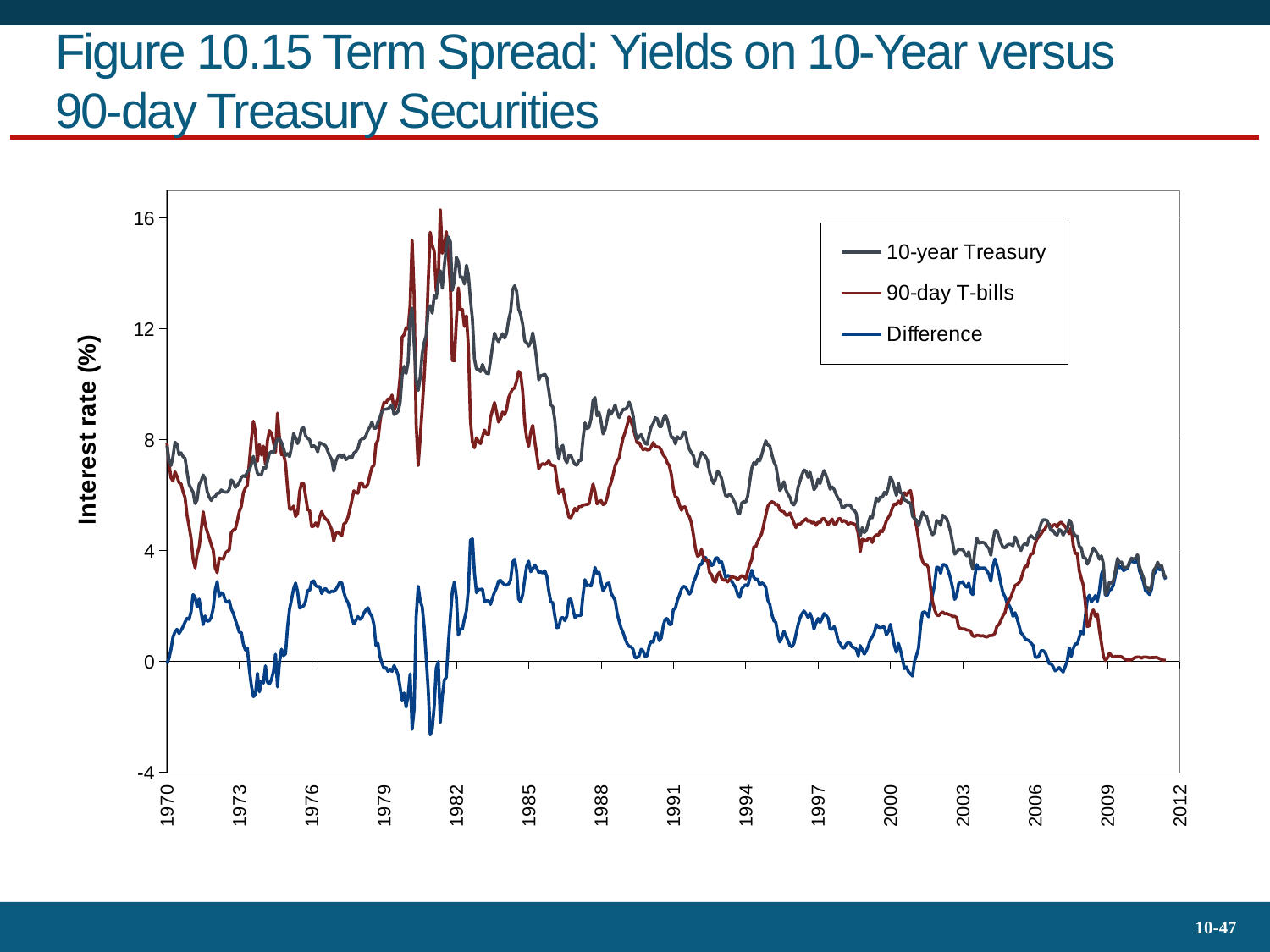
How many series does the legend list? 3 What is the label on the vertical axis? Interest rate (%) What kind of chart is shown on the slide? line chart How many year labels are shown on the horizontal axis? 15 Is the value of the 90-day T-bills series in 2010 greater or less than 4? less What are the three series named in the legend? 10-year Treasury, 90-day T-bills, Difference Is the peak value of the 10-year Treasury series around 1981-1982 greater or less than 12? greater Does the 10-year Treasury series generally rise or fall from 1985 to 2012? fall What is the highest value shown on the vertical axis? 16 Is the lowest value reached by the Difference series greater or less than -2? less In 2010, which series is higher: 10-year Treasury or 90-day T-bills? 10-year Treasury